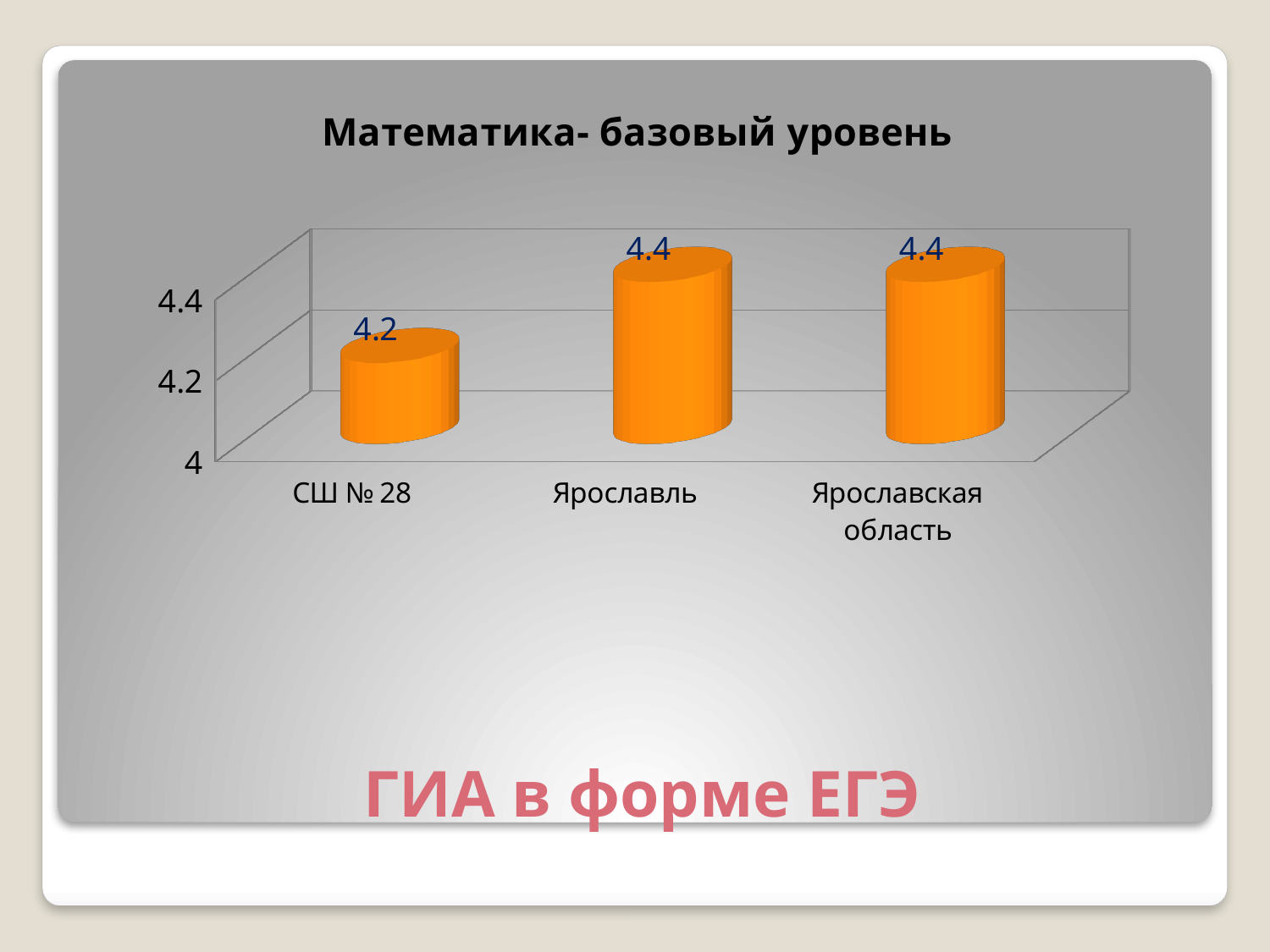
What colour are the bars in the chart? orange Which is larger, the value for СШ № 28 or the value for Ярославская область? Ярославская область What is the value for Ярославская область? 4.4 Is the value for СШ № 28 greater or less than 4.4? less What is the value for СШ № 28? 4.2 What is the difference between the values for Ярославль and СШ № 28? 0.2 Which category has the lowest value? СШ № 28 How many categories are shown on the chart? 3 What kind of chart is shown on the slide? bar chart Is the value for Ярославль greater or less than 4.2? greater What is the title of the chart? Математика- базовый уровень What is the value for Ярославль? 4.4